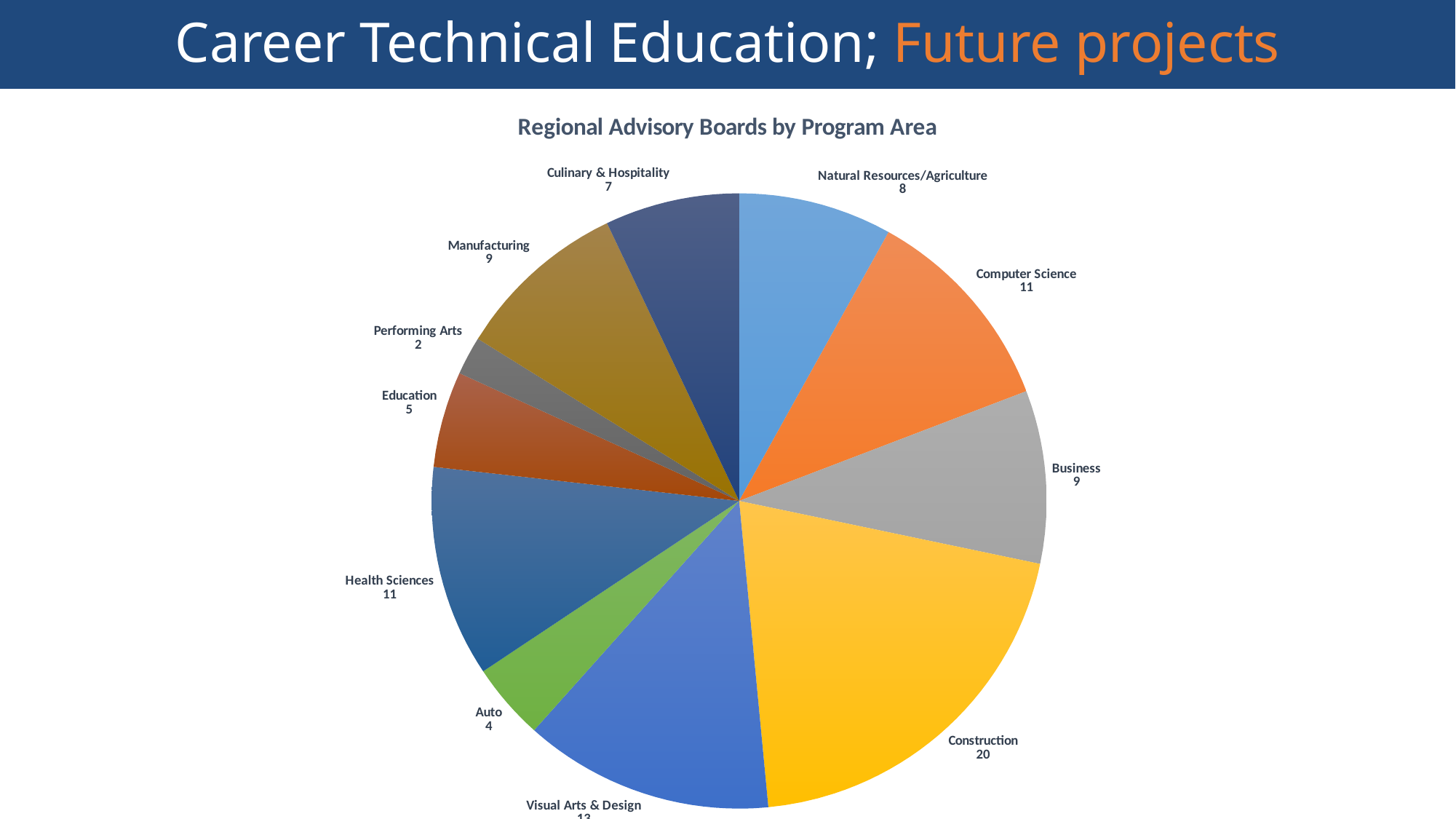
What is the title of the chart? Regional Advisory Boards by Program Area What is the value for Culinary & Hospitality? 7 What is the value for Health Sciences? 11 Which program area has the smallest slice? Performing Arts How many program areas are shown in the pie chart? 11 Which program area has the largest slice? Construction What is the value for Construction? 20 Which is larger, the value for Manufacturing or the value for Education? Manufacturing What is the value for Performing Arts? 2 What is the difference between the values for Natural Resources/Agriculture and Auto? 4 What kind of chart is shown on the slide? pie chart What is the difference between the values for Construction and Computer Science? 9